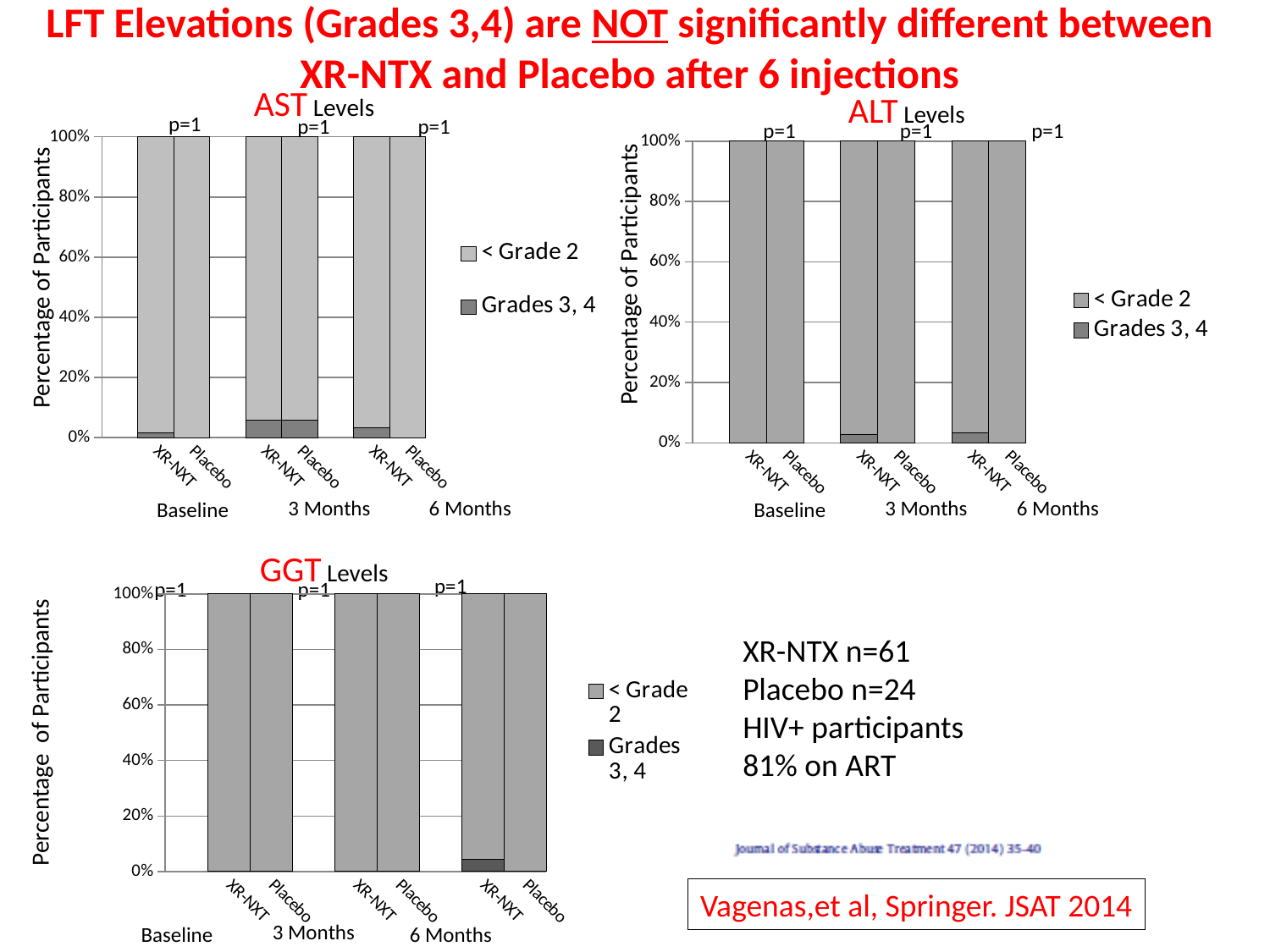
In the AST Levels chart, what is the total height of the stacked bar for XR-NXT at Baseline? 100% In the AST Levels chart, is the Grades 3, 4 share for Placebo at 3 Months greater or less than 20%? less What p-value is printed above each pair of bars in the ALT Levels chart? p=1 In the AST Levels chart, which is larger: the Grades 3, 4 share for XR-NXT at 3 Months or for XR-NXT at Baseline? XR-NXT at 3 Months What is the y-axis label of the GGT Levels chart? Percentage of Participants In the ALT Levels chart, is the < Grade 2 share for XR-NXT at 6 Months greater or less than 80%? greater How many series does the legend of the ALT Levels chart list? 2 In the ALT Levels chart, what is the total of the stacked bar for Placebo at 6 Months? 100% In the GGT Levels chart, is the Grades 3, 4 share for XR-NXT at 6 Months greater or less than 20%? less In the GGT Levels chart, which time point shows a visible Grades 3, 4 segment for XR-NXT? 6 Months How many bars are plotted in the GGT Levels chart? 6 What kind of chart is the AST Levels chart? stacked bar chart